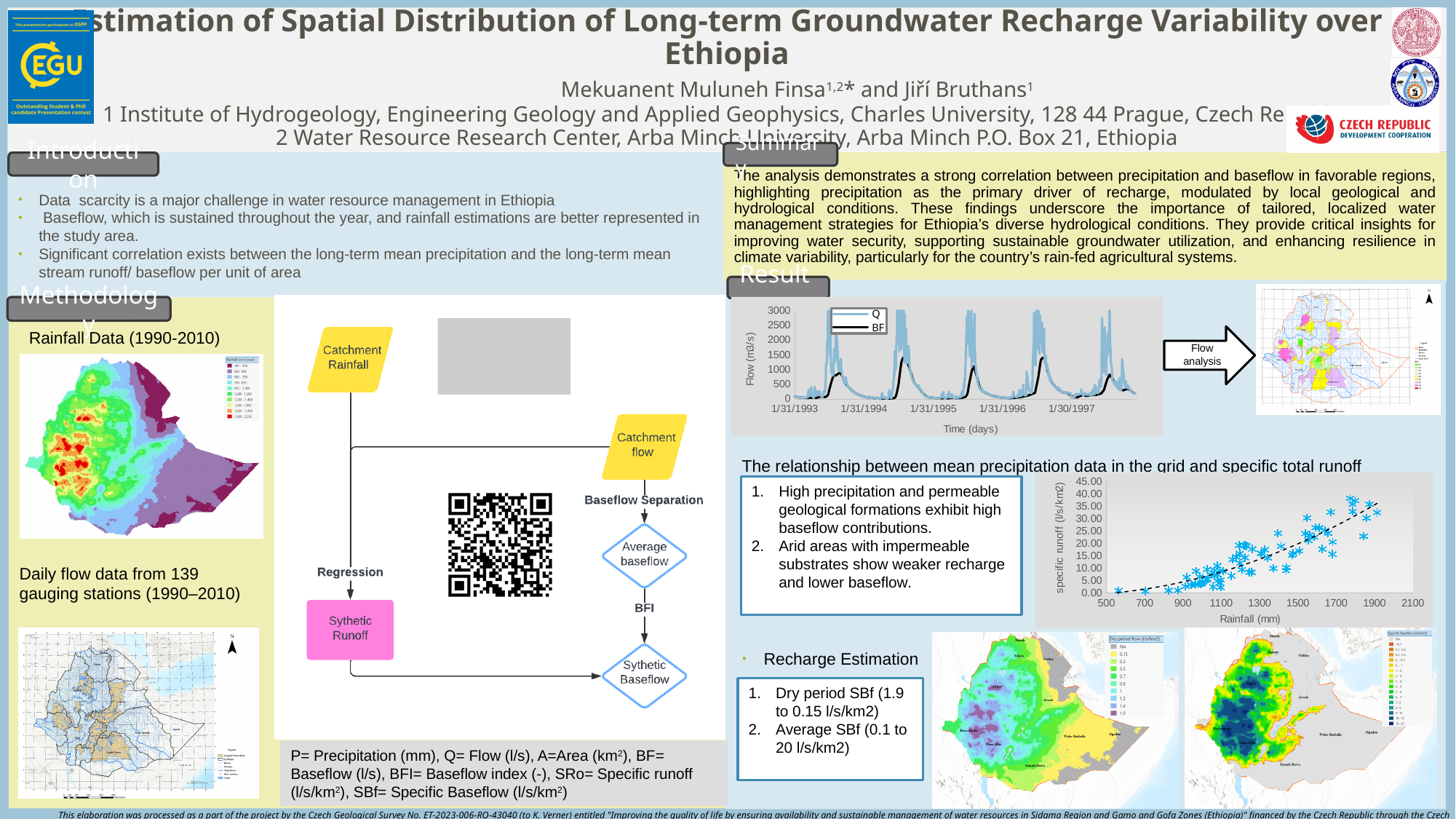
In the flow-over-time chart in the Result section, which series reaches higher peak values, Q or BF? Q In the flow-over-time chart in the Result section, is the highest value of the BF series greater or less than 2000? less In the flow-over-time chart in the Result section, how many series does the legend list? 2 In the chart of specific runoff against rainfall, do the specific runoff values rise or fall as rainfall increases? rise In the chart of specific runoff against rainfall, what kind of chart is shown? scatter chart In the flow-over-time chart in the Result section, what are the two series named in the legend? Q and BF In the flow chart at the top of the Result section, what kind of chart is used to show Q and BF over time? line chart In the flow-over-time chart in the Result section, what is the label of the y axis? Flow (m3/s) In the flow-over-time chart in the Result section, is the highest peak of the Q series greater or less than 2000? greater In the chart of specific runoff against rainfall, is the highest plotted specific runoff value greater or less than 35.00? greater In the chart of specific runoff against rainfall, what is the highest value shown on the y axis? 45.00